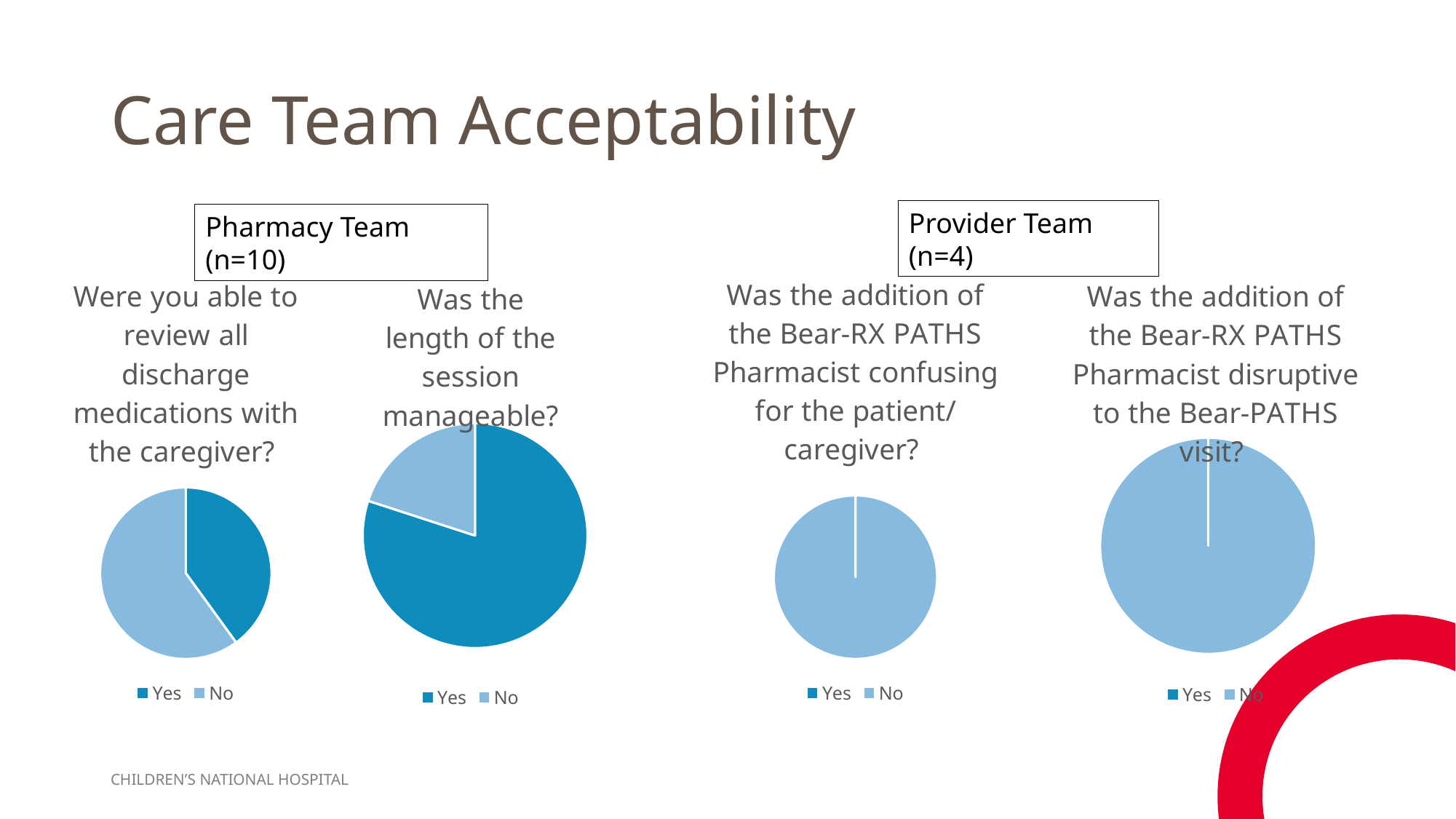
In the chart "Was the length of the session manageable?", which response has the smallest slice? No What is the sample size shown for the Provider Team charts? n=4 What is the sample size shown for the Pharmacy Team charts? n=10 In the chart "Was the length of the session manageable?", which response is the larger slice, Yes or No? Yes In the chart "Were you able to review all discharge medications with the caregiver?", which response is the larger slice, Yes or No? No In the chart "Were you able to review all discharge medications with the caregiver?", which response has the largest slice? No How many entries does the legend list for the chart "Were you able to review all discharge medications with the caregiver?"? 2 How many pie charts are shown on the slide? 4 What kind of chart is used for "Was the length of the session manageable?"? pie chart In the chart "Was the addition of the Bear-RX PATHS Pharmacist disruptive to the Bear-PATHS visit?", which response makes up the entire pie? No How many response categories are shown in the legend of the chart "Was the addition of the Bear-RX PATHS Pharmacist disruptive to the Bear-PATHS visit?"? 2 In the chart "Was the addition of the Bear-RX PATHS Pharmacist confusing for the patient/caregiver?", which response makes up the entire pie? No